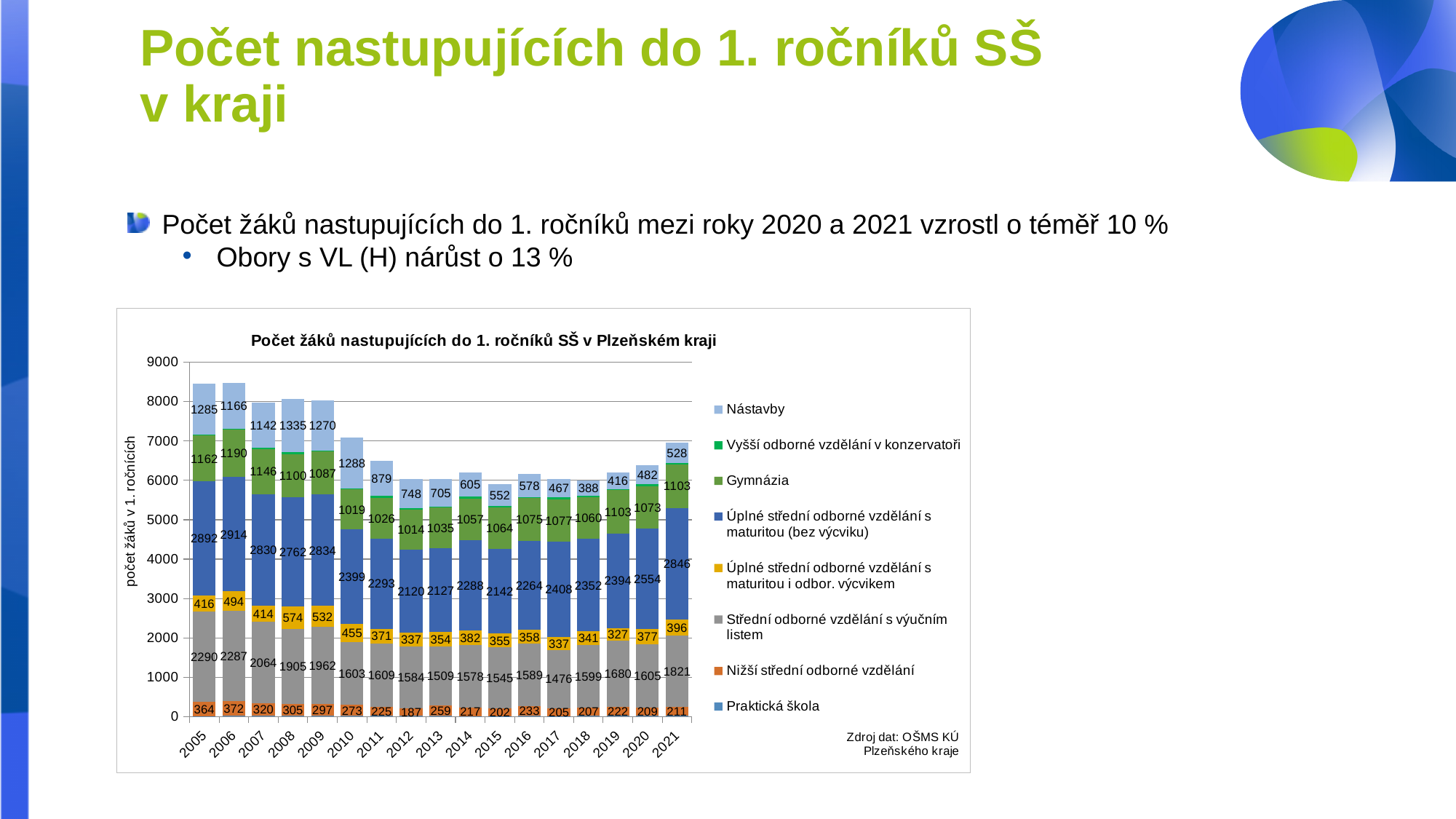
What is the value for Gymnázia in 2021? 1103 Is the total height of the 2021 bar greater or less than 6000? greater What is the value for Úplné střední odborné vzdělání s maturitou (bez výcviku) in 2021? 2846 Which is larger, the Gymnázia value for 2005 or for 2021? 2005 In which year is the Nástavby value highest? 2008 How many years are shown on the x axis? 17 What is the difference between the Střední odborné vzdělání s výučním listem values for 2021 and 2020? 216 What is the value for Nástavby in 2005? 1285 How many series does the legend list? 8 What kind of chart is shown? stacked bar chart What is the value for Nižší střední odborné vzdělání in 2005? 364 In which year is the Nižší střední odborné vzdělání value lowest? 2012